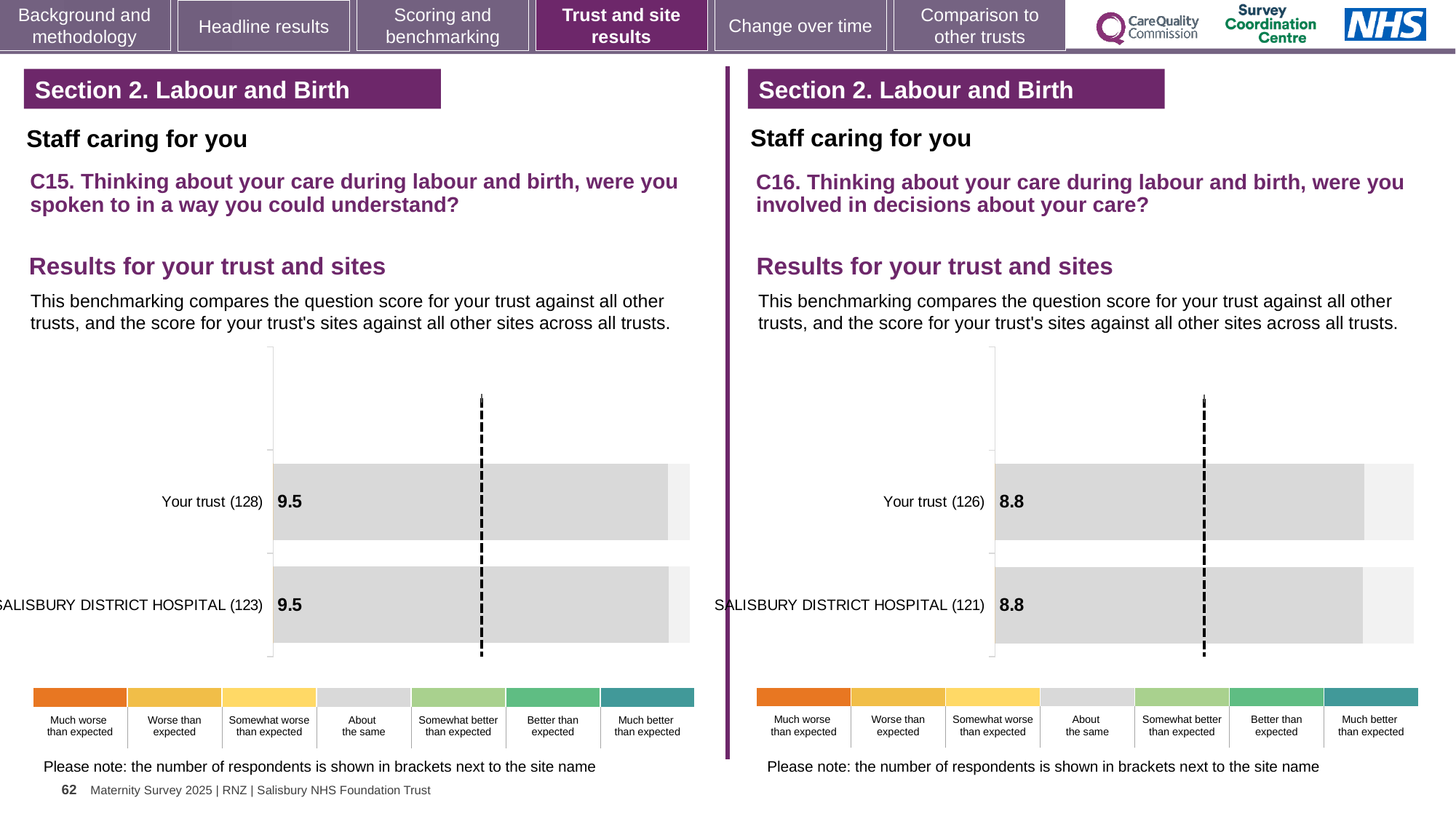
On the right chart (C16), how many respondents are shown in brackets for SALISBURY DISTRICT HOSPITAL? 121 On the left chart (C15), what is the score for SALISBURY DISTRICT HOSPITAL? 9.5 According to the colour key below the right chart (C16), which benchmark category do the grey bars represent? About the same On the right chart (C16), what is the score for SALISBURY DISTRICT HOSPITAL? 8.8 On the left chart (C15), what is the score for Your trust? 9.5 How many bars are plotted on the left chart (C15)? 2 On the right chart (C16), what is the score for Your trust? 8.8 On the left chart (C15), what is the difference between the Your trust score and the SALISBURY DISTRICT HOSPITAL score? 0 On the right chart (C16), what is the difference between the Your trust score and the SALISBURY DISTRICT HOSPITAL score? 0 What kind of chart is used on the left (C15)? Bar chart How many bars are plotted on the right chart (C16)? 2 On the left chart (C15), how many respondents are shown in brackets for Your trust? 128